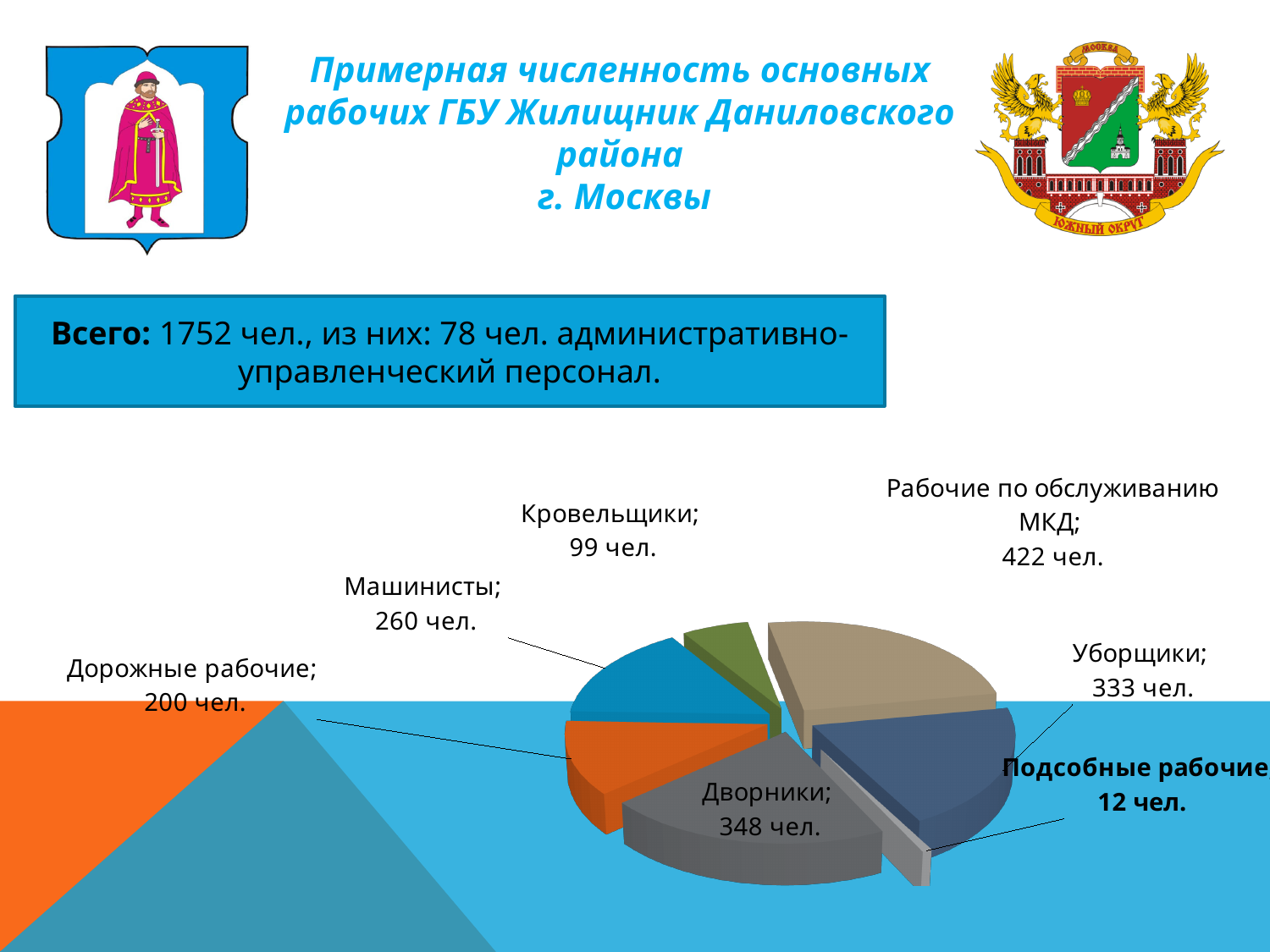
What is the difference between the values for Дворники and Уборщики? 15 чел. What kind of chart is shown on the slide? Pie chart What is the difference between the values for Машинисты and Дорожные рабочие? 60 чел. Which is larger, the value for Кровельщики or the value for Дорожные рабочие? Дорожные рабочие What is the value for Подсобные рабочие? 12 чел. What is the value for Машинисты? 260 чел. What is the value for Рабочие по обслуживанию МКД? 422 чел. How many categories does the pie chart show? 7 What is the value for Дворники in the pie chart? 348 чел. What total number of people is stated in the text box above the chart? 1752 чел. Which category has the smallest value in the pie chart? Подсобные рабочие Which category has the largest value in the pie chart? Рабочие по обслуживанию МКД